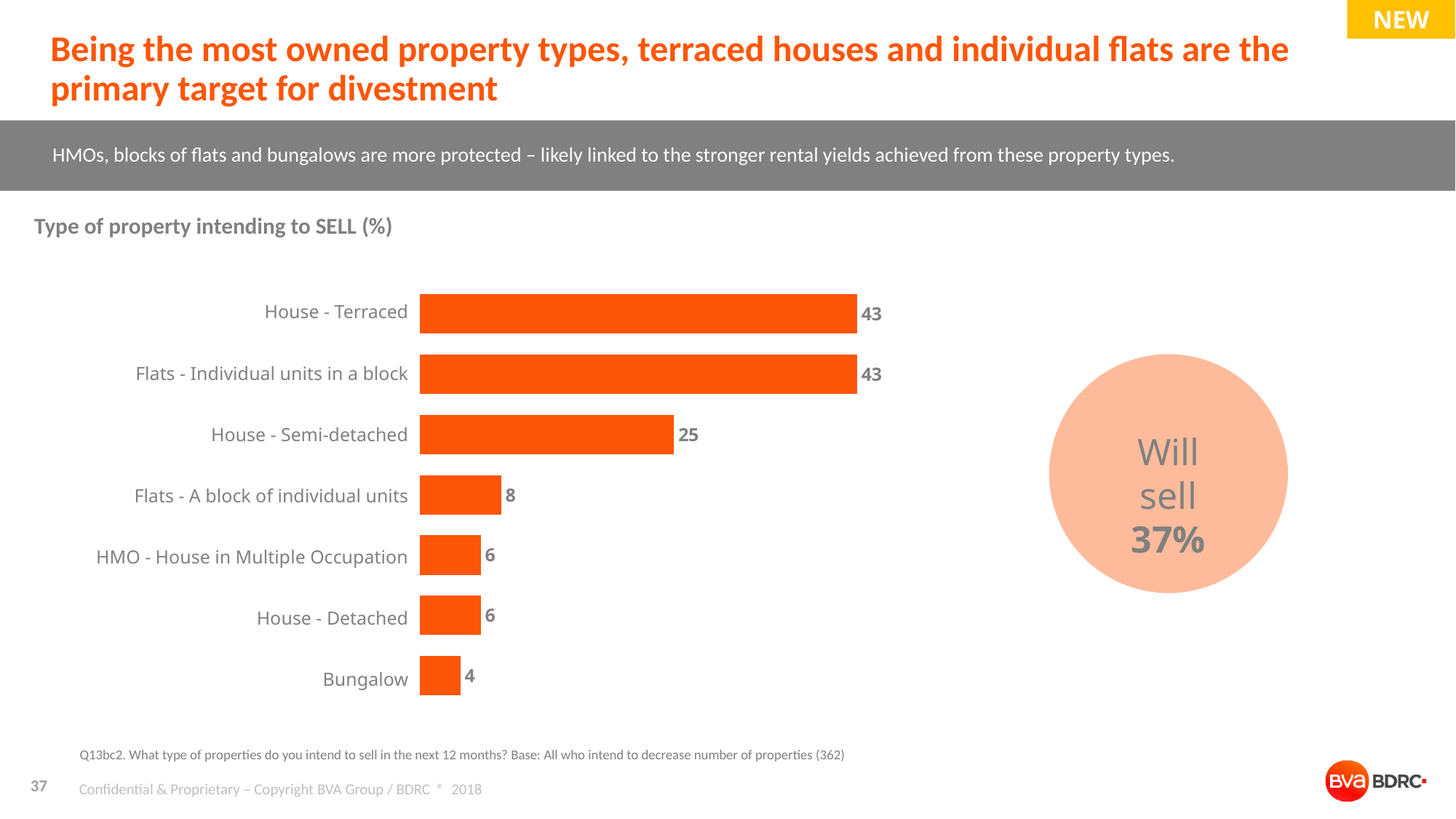
What is the difference between House - Semi-detached and Flats - A block of individual units? 17 Which category has the lowest value? Bungalow What is the value for HMO - House in Multiple Occupation? 6 What is the value for Flats - A block of individual units? 8 What is the difference between Flats - Individual units in a block and House - Semi-detached? 18 How many property categories are shown in the chart? 7 What is the title of the chart? Type of property intending to SELL (%) What kind of chart is shown on the slide? Bar chart What is the value for Bungalow? 4 What is the value for House - Semi-detached? 25 Which is larger, House - Semi-detached or House - Detached? House - Semi-detached What is the value for House - Terraced? 43